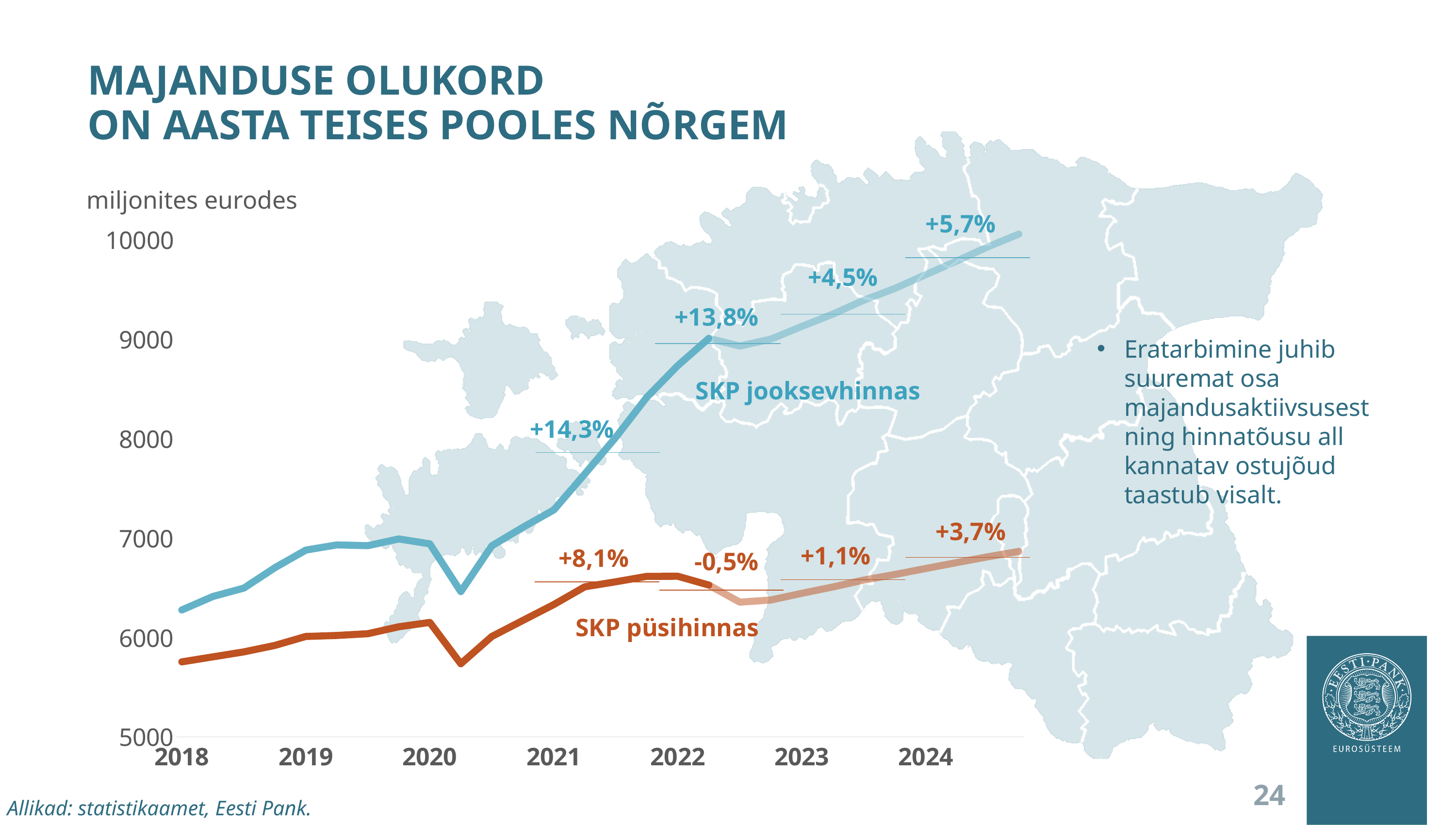
What growth rate is labelled for SKP püsihinnas in 2022? -0,5% What growth rate is labelled for SKP jooksevhinnas in 2024? +5,7% Which labelled growth rate for SKP jooksevhinnas is the highest? +14,3% What growth rate is labelled for SKP jooksevhinnas in 2021? +14,3% Which labelled growth rate for SKP püsihinnas is the lowest? -0,5% What unit is given for the y axis of the chart? miljonites eurodes What growth rate is labelled for SKP püsihinnas in 2023? +1,1% Which is larger in 2023: the labelled growth of SKP jooksevhinnas or SKP püsihinnas? SKP jooksevhinnas How many series are plotted on the chart? 2 What is the difference in percentage points between the 2021 growth labels of SKP jooksevhinnas (+14,3%) and SKP püsihinnas (+8,1%)? 6,2 percentage points What type of chart is shown on the slide? line chart Is the value of SKP püsihinnas at the start of 2018 greater or less than 6000? less